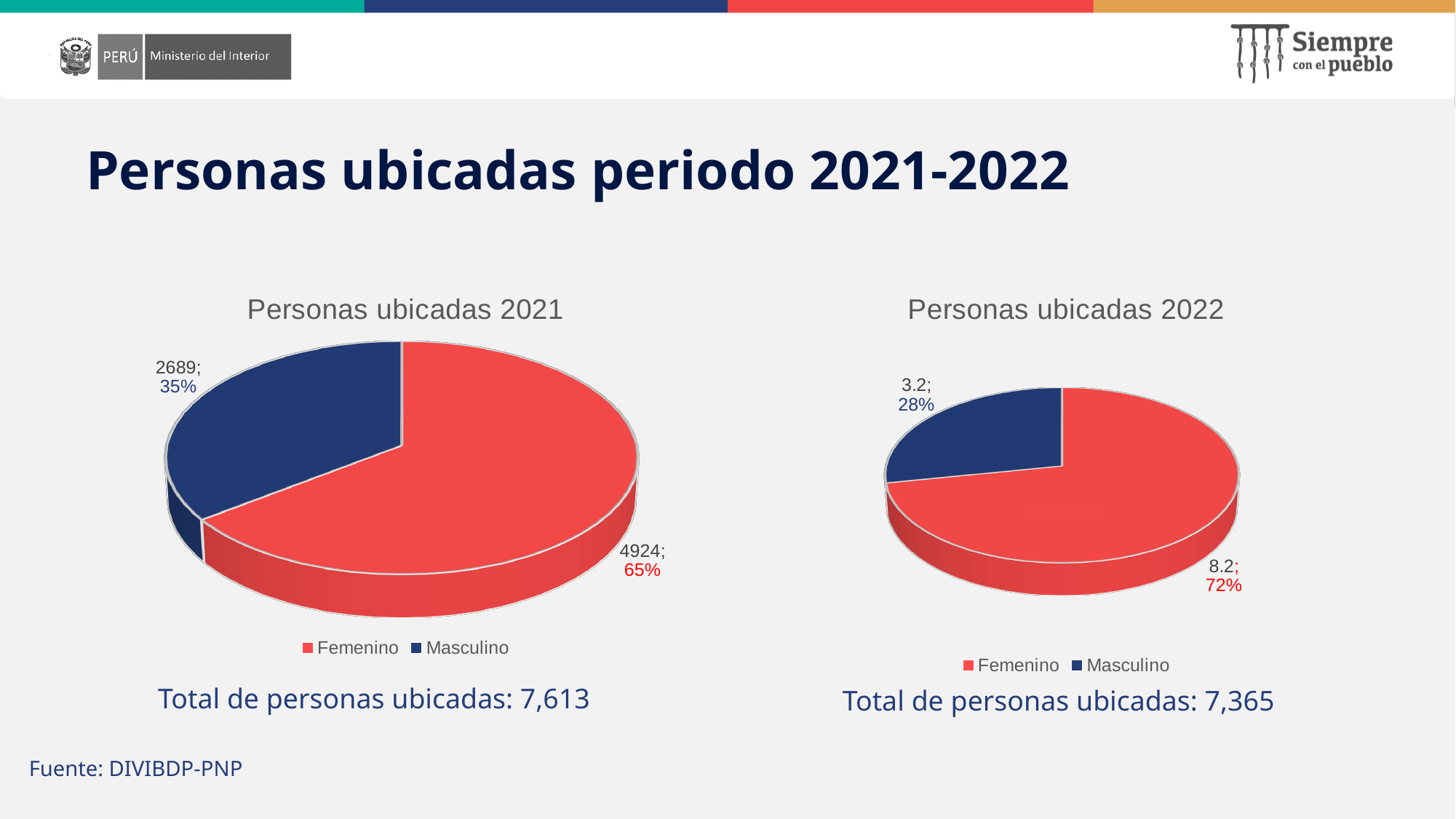
In the 'Personas ubicadas 2021' chart, what is the difference between the Femenino and Masculino values? 2235 In the 'Personas ubicadas 2022' chart, what value is labelled on the Femenino slice? 8.2 In the 'Personas ubicadas 2021' chart, which category has the largest slice? Femenino In the 'Personas ubicadas 2021' chart, what is the value for Femenino? 4924 What kind of chart is 'Personas ubicadas 2022'? Pie chart In the 'Personas ubicadas 2022' chart, which category has the smallest slice? Masculino In the 'Personas ubicadas 2021' chart, what is the value for Masculino? 2689 In the 'Personas ubicadas 2022' chart, what share of the pie is Masculino? 28% How many series does the legend of the 'Personas ubicadas 2021' chart list? 2 In the 'Personas ubicadas 2021' chart, what share of the pie is Femenino? 65% In the 'Personas ubicadas 2021' chart, what share of the pie is Masculino? 35%